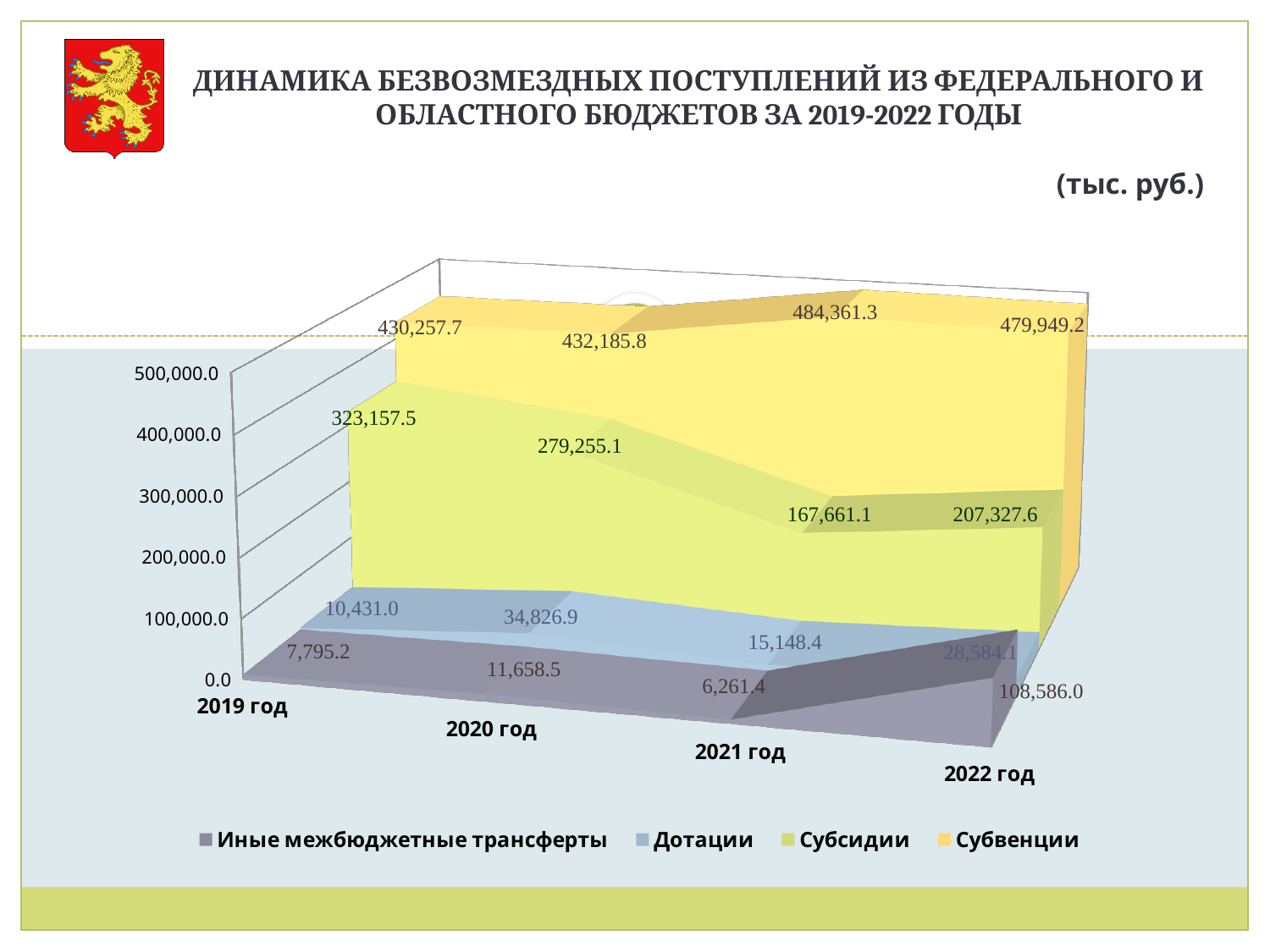
How many series does the legend list? 4 In which year is the value of Субвенции the highest? 2021 год What is the value of Иные межбюджетные трансферты for 2022 год? 108,586.0 In which year is the value of Субсидии the lowest? 2021 год What is the value of Субвенции for 2021 год? 484,361.3 What is the value of Дотации for 2020 год? 34,826.9 Does the value of Субсидии rise or fall from 2019 год to 2021 год? Fall How many years are shown on the x axis? 4 Which is larger: Дотации in 2021 год or Дотации in 2022 год? Дотации in 2022 год What is the value of Субсидии for 2019 год? 323,157.5 What is the difference between the Субсидии values for 2019 год and 2020 год? 43,902.4 What kind of chart is shown on the slide? Area chart